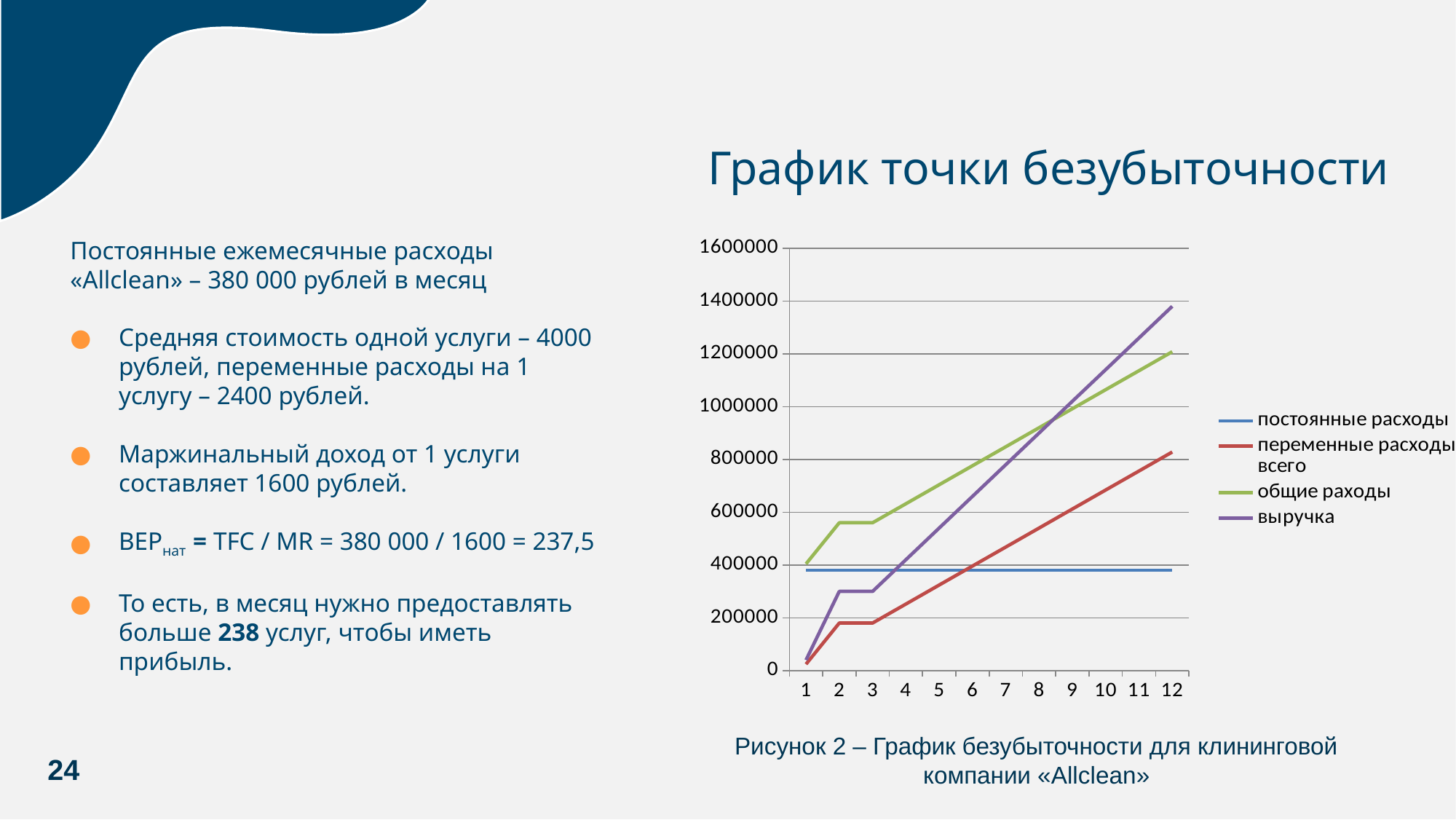
Is the value of выручка at point 1 greater or less than 200000? less Is the value of выручка at point 12 greater or less than 1200000? greater Is the value of переменные расходы всего at point 12 greater or less than 1000000? less At point 4, which is larger: общие раходы or выручка? общие раходы Which series has the highest value at point 12? выручка Which series has the lowest value at point 12? постоянные расходы How many points are on the x axis of the chart? 12 What kind of chart is shown on the slide? line chart How many series does the chart legend list? 4 At point 12, which is larger: переменные расходы всего or постоянные расходы? переменные расходы всего Does the выручка series rise or fall along the x axis? rise